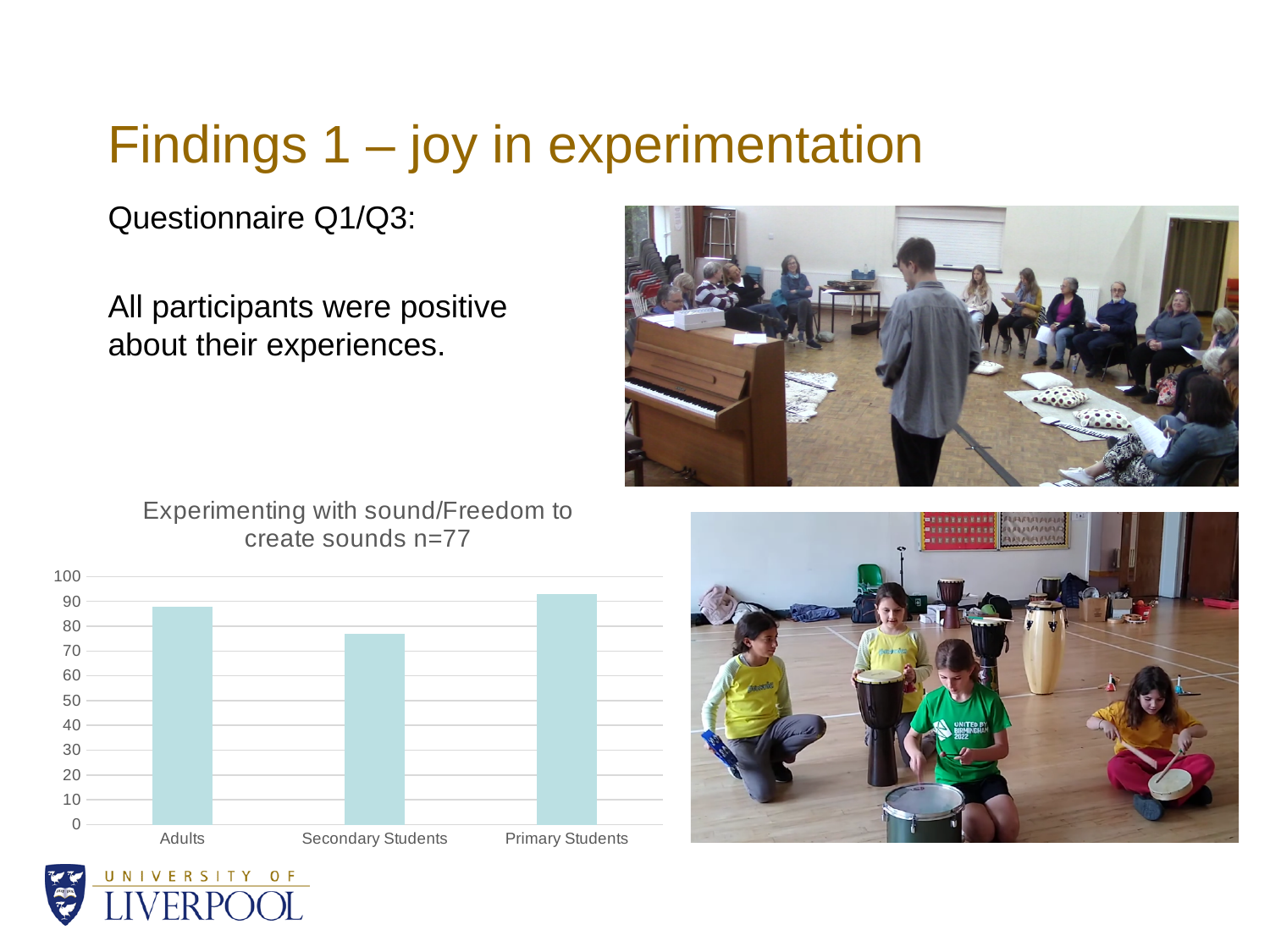
Which is larger, the value for Adults or the value for Secondary Students? Adults What kind of chart is shown on the slide? bar chart What is the title of the chart? Experimenting with sound/Freedom to create sounds n=77 Which category has the lowest bar in the chart? Secondary Students Is the value for Secondary Students greater or less than 80? less Which is larger, the value for Primary Students or the value for Secondary Students? Primary Students How many categories are shown on the x axis of the chart? 3 Which category has the highest bar in the chart? Primary Students Is the value for Primary Students greater or less than 80? greater Is the value for Adults greater or less than 80? greater What is the highest value shown on the y axis of the chart? 100